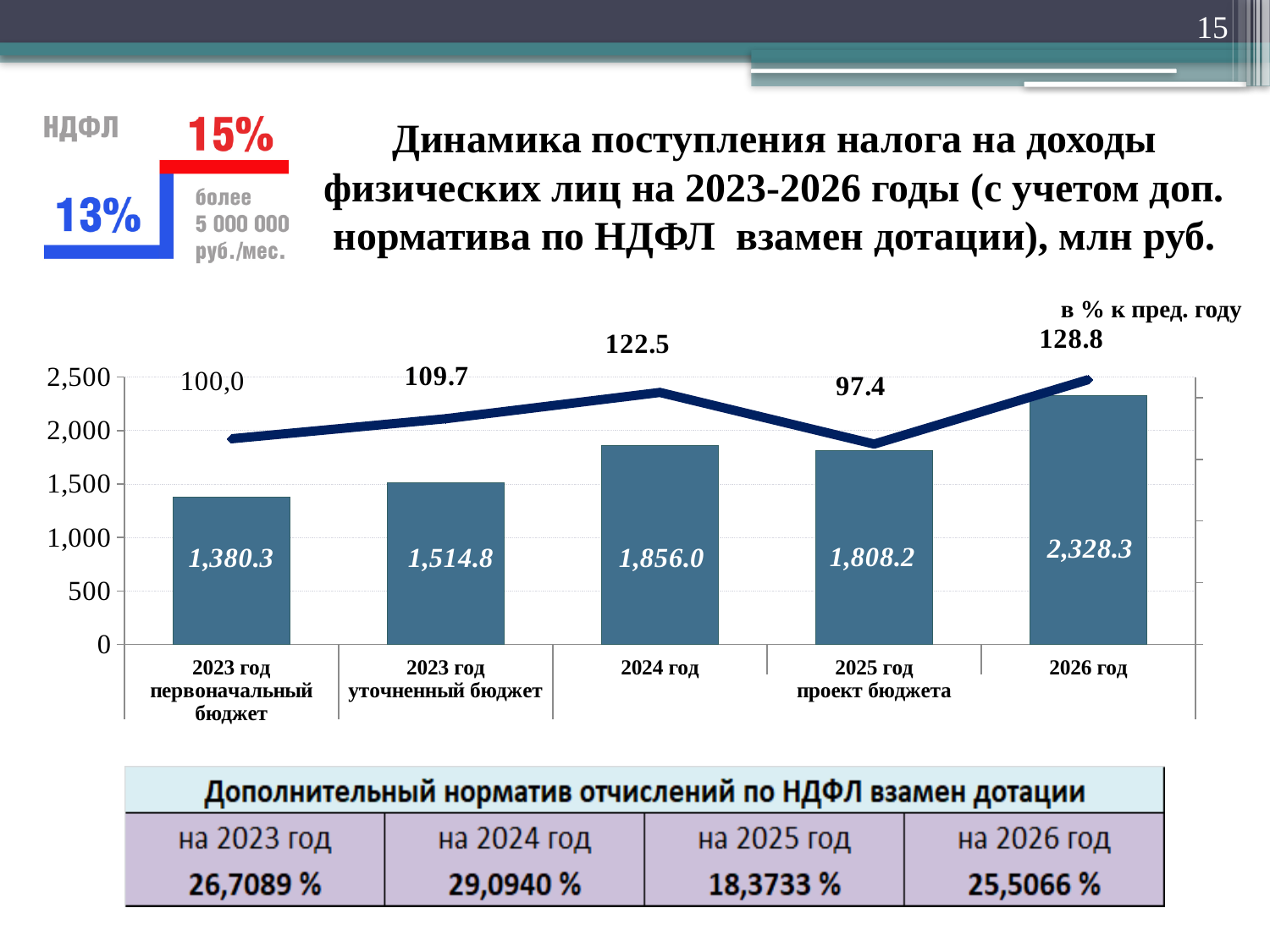
How many bars are plotted in the chart? 5 Which category has the highest bar value? 2026 год What kind of chart is shown on the slide? Bar chart with a line Which category has the lowest bar value? 2023 год первоначальный бюджет Which bar is larger: 2024 год or 2025 год проект бюджета? 2024 год What is the line value (в % к пред. году) shown above 2026 год? 128.8 What is the difference between the bar values for 2026 год and 2025 год проект бюджета? 520.1 Is the bar value for 2023 год уточненный бюджет greater or less than 2,000? less What is the value of the bar for 2023 год первоначальный бюджет? 1,380.3 What is the line value (в % к пред. году) shown above 2025 год проект бюджета? 97.4 What is the value of the bar for 2024 год? 1,856.0 What is the value of the bar for 2026 год? 2,328.3